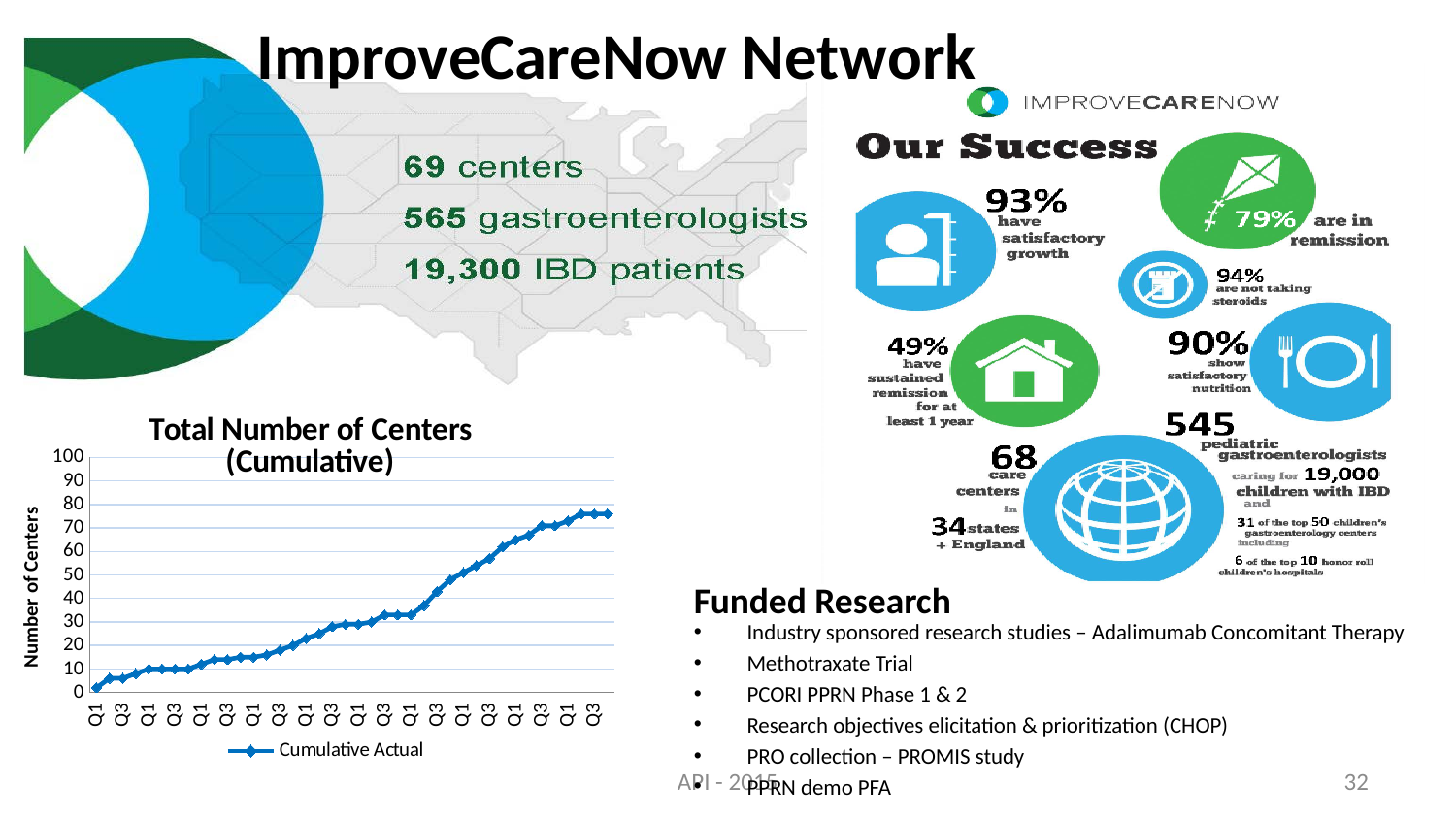
In the "Total Number of Centers (Cumulative)" chart, is the value at the last point greater or less than 70? greater How many series does the legend of the "Total Number of Centers (Cumulative)" chart list? 1 What is the name of the series shown in the legend of the "Total Number of Centers (Cumulative)" chart? Cumulative Actual What is the label on the vertical axis of the "Total Number of Centers (Cumulative)" chart? Number of Centers In the "Total Number of Centers (Cumulative)" chart, is the highest value greater or less than 80? less In the "Total Number of Centers (Cumulative)" chart, is the value at the last point larger than the value at the first point? yes What kind of chart is "Total Number of Centers (Cumulative)"? line chart Do the values in the "Total Number of Centers (Cumulative)" chart rise or fall along the x axis? rise In the "Total Number of Centers (Cumulative)" chart, is the value at the first point greater or less than 10? less What is the maximum value shown on the vertical axis of the "Total Number of Centers (Cumulative)" chart? 100